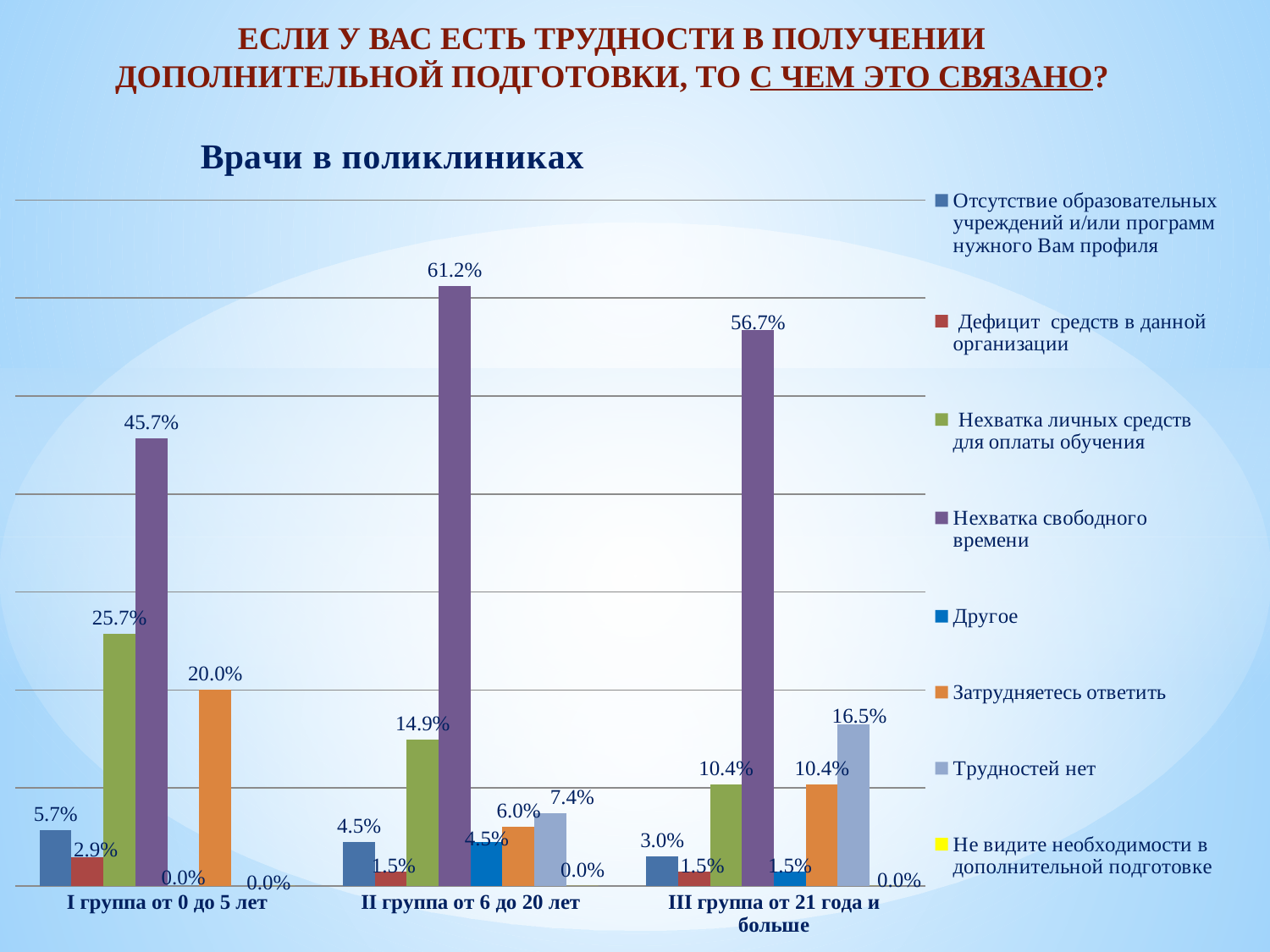
What is the value for 'Трудностей нет' in 'III группа от 21 года и больше'? 16.5% What is the value for 'Нехватка личных средств для оплаты обучения' in 'I группа от 0 до 5 лет'? 25.7% Which group has the lowest value for 'Нехватка личных средств для оплаты обучения'? III группа от 21 года и больше Which is larger in 'I группа от 0 до 5 лет': 'Нехватка личных средств для оплаты обучения' or 'Затрудняетесь ответить'? Нехватка личных средств для оплаты обучения What is the subtitle of the chart? Врачи в поликлиниках How many age groups are shown on the x axis? 3 What type of chart is shown on the slide? bar chart Which group has the highest value for 'Нехватка свободного времени'? II группа от 6 до 20 лет How many series does the legend list? 8 What is the value for 'Нехватка свободного времени' in 'I группа от 0 до 5 лет'? 45.7% What is the value for 'Нехватка свободного времени' in 'II группа от 6 до 20 лет'? 61.2% What is the difference between the 'Нехватка свободного времени' values for 'II группа от 6 до 20 лет' and 'III группа от 21 года и больше'? 4.5%